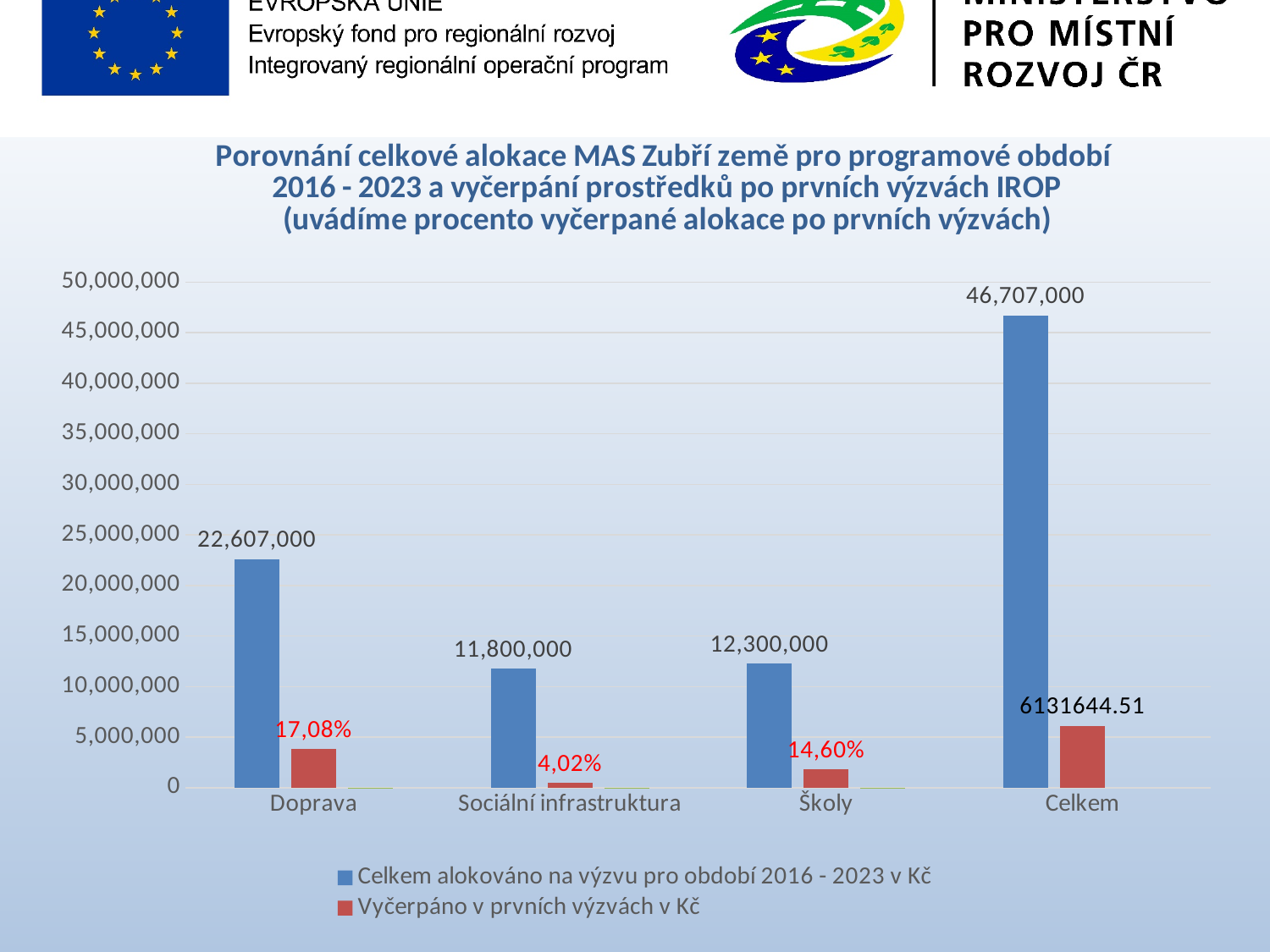
What is the difference between the allocated amounts for Celkem and Doprava? 24,100,000 What value is printed on the 'Vyčerpáno v prvních výzvách v Kč' bar for Celkem? 6131644.51 Which category has the highest value for 'Celkem alokováno na výzvu pro období 2016 - 2023 v Kč'? Celkem What is the difference between the allocated amounts for Školy and Sociální infrastruktura? 500,000 What is the value of 'Celkem alokováno na výzvu pro období 2016 - 2023 v Kč' for Doprava? 22,607,000 Which has a larger allocated amount, Doprava or Školy? Doprava What label is shown on the 'Vyčerpáno v prvních výzvách v Kč' bar for Doprava? 17,08% Which category has the lowest value for 'Celkem alokováno na výzvu pro období 2016 - 2023 v Kč'? Sociální infrastruktura What is the value of 'Celkem alokováno na výzvu pro období 2016 - 2023 v Kč' for Celkem? 46,707,000 Is the 'Vyčerpáno v prvních výzvách v Kč' bar for Doprava greater or less than 5,000,000? less How many series does the legend list? 2 How many categories are shown on the x axis? 4